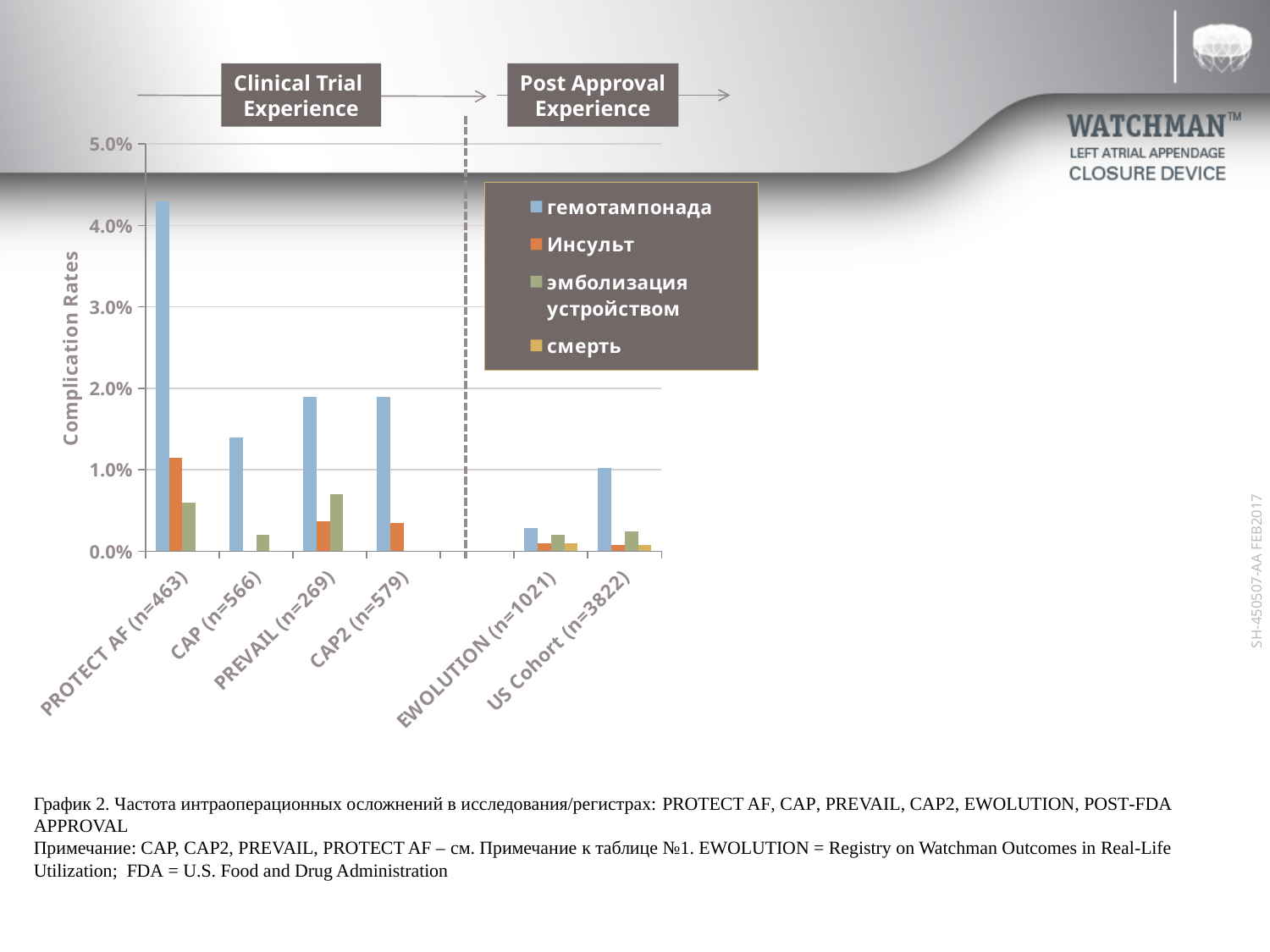
What is the title of the vertical axis? Complication Rates Which study has the highest гемотампонада rate? PROTECT AF (n=463) Which study has the highest Инсульт rate? PROTECT AF (n=463) Is the гемотампонада value for CAP (n=566) greater or less than 1.0%? greater Which is larger, the эмболизация устройством rate for PREVAIL (n=269) or for CAP (n=566)? PREVAIL (n=269) Is the гемотампонада value for EWOLUTION (n=1021) greater or less than 1.0%? less Which is larger, the Инсульт rate for PROTECT AF (n=463) or for PREVAIL (n=269)? PROTECT AF (n=463) What kind of chart is shown on the slide? Bar chart How many studies/registries are shown along the x axis? 6 Is the гемотампонада value for PROTECT AF (n=463) greater or less than 4.0%? greater Which study has the lowest гемотампонада rate? EWOLUTION (n=1021) How many series does the legend list? 4